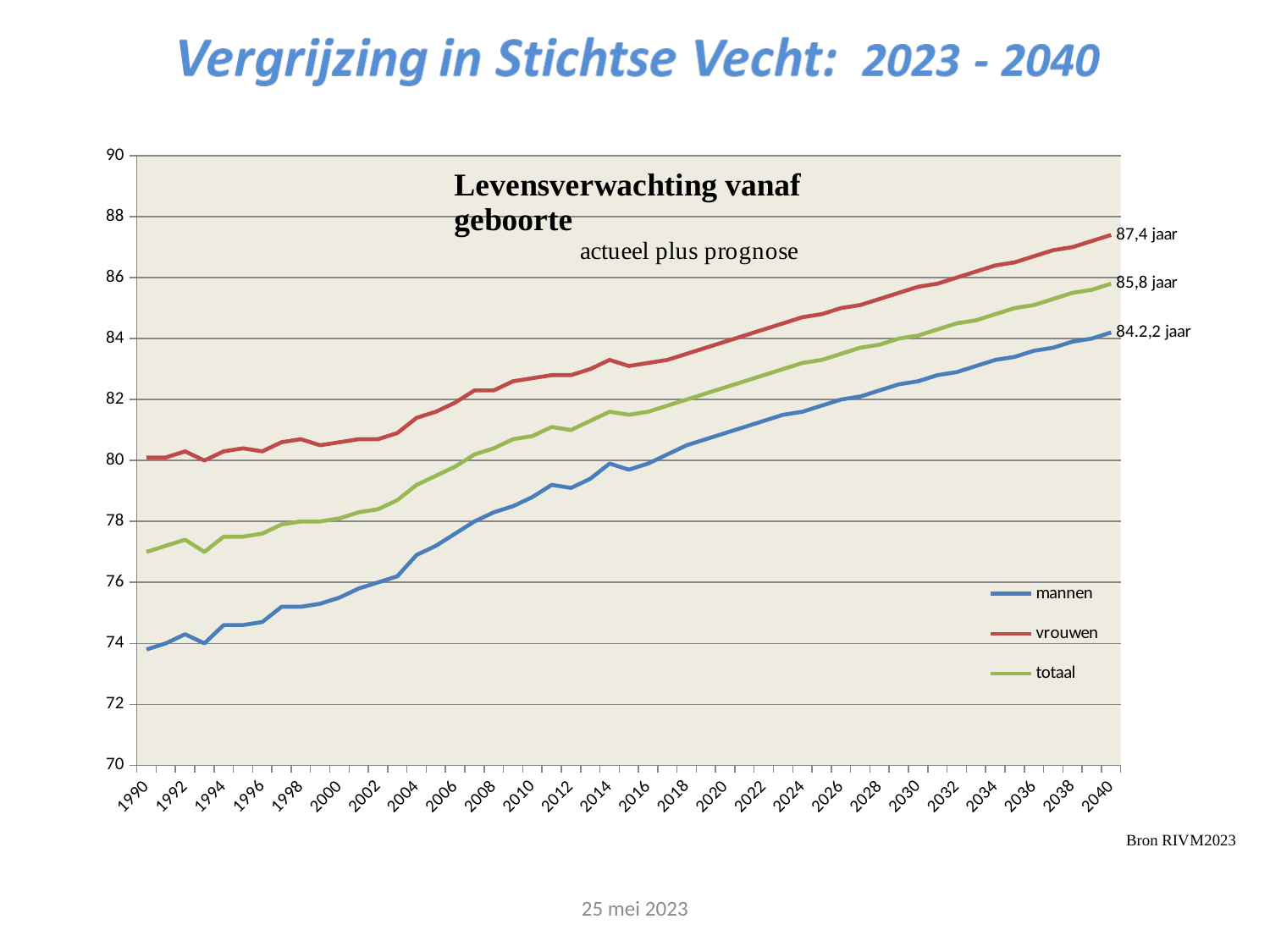
What is the value labelled for totaal at the end of the chart (2040)? 85,8 jaar What is the life expectancy value labelled for vrouwen at the end of the chart (2040)? 87,4 jaar Which series has the highest values across the whole chart? vrouwen How many series does the chart legend list? 3 Which series has the lowest values across the whole chart? mannen In 2040, which series has the higher value, vrouwen or mannen? vrouwen Is the value for mannen in 1990 greater or less than 76? less What is the difference between the 2040 labelled values for vrouwen and totaal? 1,6 jaar Is the value for totaal in 1990 greater or less than 76? greater Do the values for mannen rise or fall from 1990 to 2040? rise What colour is the line for totaal in the chart? green What kind of chart is shown on the slide? line chart